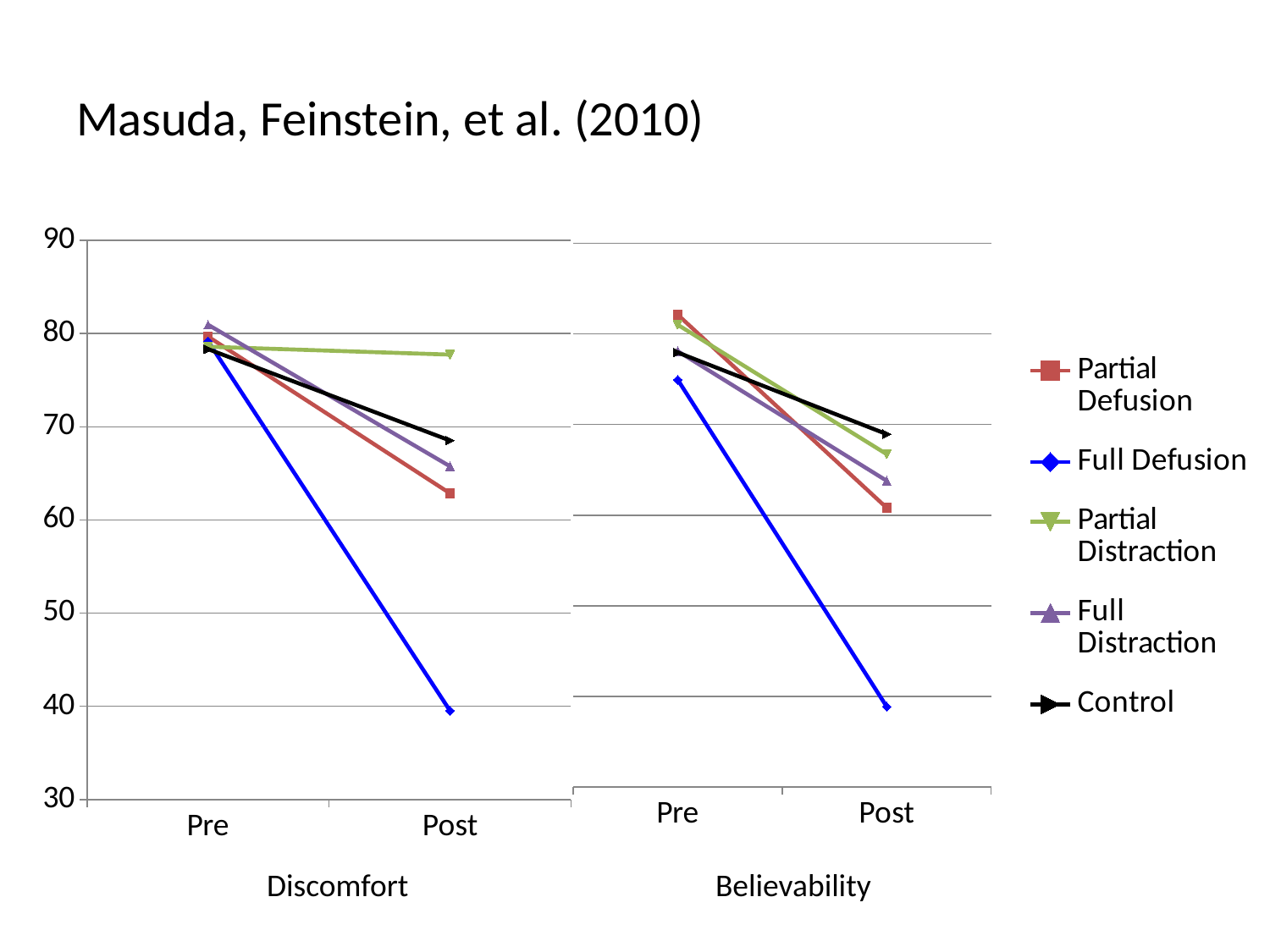
In the Discomfort chart, is the Post value for Full Defusion greater or less than 50? less What kind of chart is the Discomfort chart? line chart In the Discomfort chart, does the Full Defusion line rise or fall from Pre to Post? fall How many series does the legend list? 5 In the Believability chart, which series has the lowest value at Post? Full Defusion In the Discomfort chart, which series has the highest value at Post? Partial Distraction In the Discomfort chart, which series has the lowest value at Post? Full Defusion In the Discomfort chart, is the Post value for Partial Distraction greater or less than 70? greater In the Believability chart, is the Pre value for Full Defusion greater or less than 80? less How many points are plotted along the x axis of the Believability chart? 2 What colour is the Control line? black In the Discomfort chart, at Post, which is larger: Partial Defusion or Full Distraction? Full Distraction